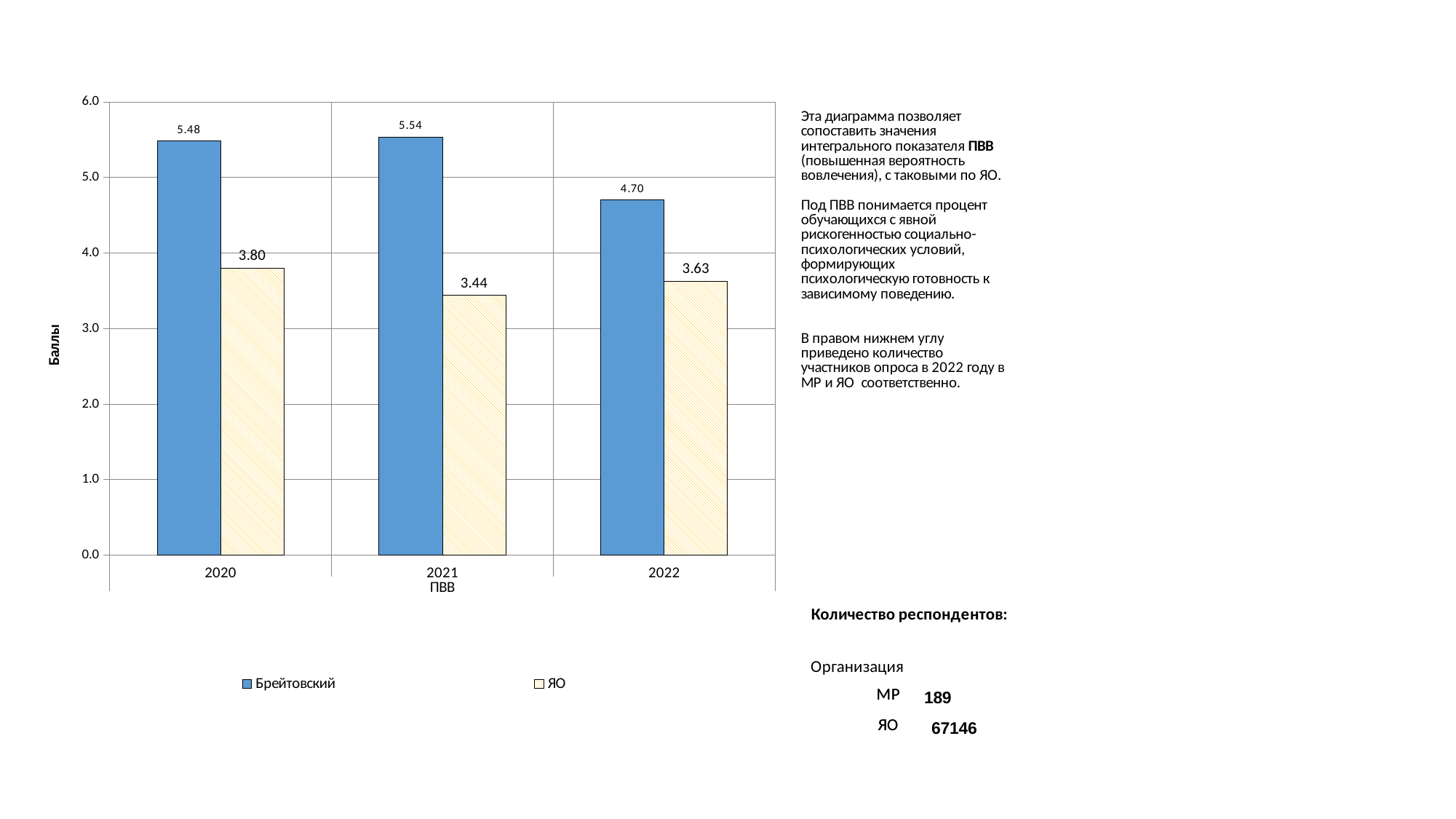
What is the value for Брейтовский in 2022? 4.70 In which year is the Брейтовский value highest? 2021 How many series does the legend list? 2 What is the value for Брейтовский in 2020? 5.48 In which year is the ЯО value lowest? 2021 What kind of chart is shown on the slide? bar chart What is the difference between the Брейтовский and ЯО values in 2020? 1.68 What is the value for ЯО in 2021? 3.44 Which is larger in 2022, the Брейтовский value or the ЯО value? Брейтовский Is the value for Брейтовский in 2021 greater or less than 5.0? greater What is the value for ЯО in 2022? 3.63 How many years are shown on the x axis? 3